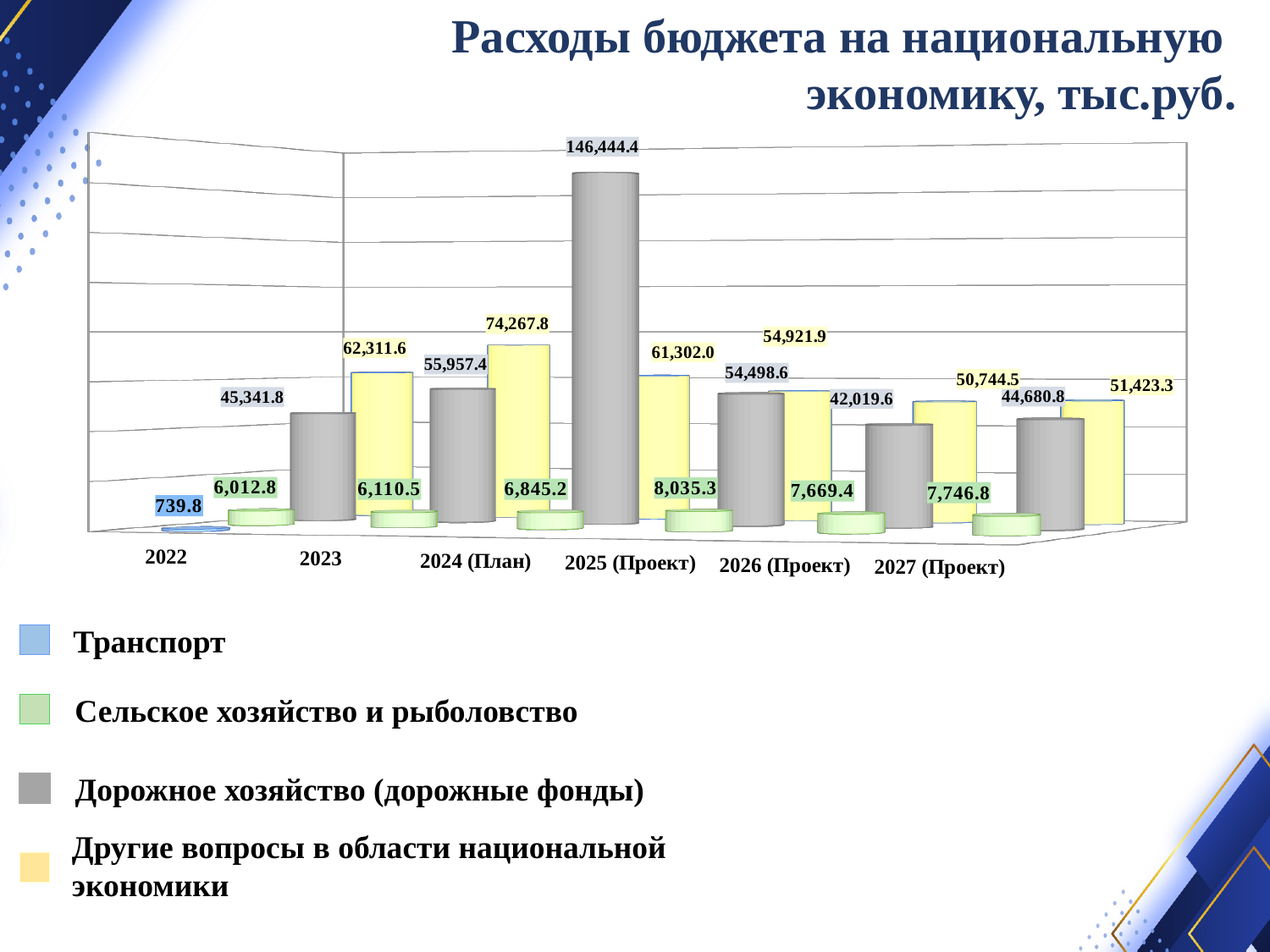
Which is larger in 2024 (План): Дорожное хозяйство (дорожные фонды) or Другие вопросы в области национальной экономики? Дорожное хозяйство (дорожные фонды) What is the difference between Другие вопросы в области национальной экономики (51,423.3) and Дорожное хозяйство (44,680.8) in 2027 (Проект)? 6,742.5 What is the value for Транспорт in 2022? 739.8 In which year does Сельское хозяйство и рыболовство reach its highest value? 2025 (Проект) What is the title of the chart? Расходы бюджета на национальную экономику, тыс.руб. What kind of chart is shown on the slide? bar chart What is the highest value shown anywhere on the chart? 146,444.4 What is the value for Сельское хозяйство и рыболовство in 2025 (Проект)? 8,035.3 Which series has the highest value on the chart? Дорожное хозяйство (дорожные фонды) How many year categories are shown on the x axis? 6 What colour represents Транспорт in the legend? blue How many series does the legend list? 4